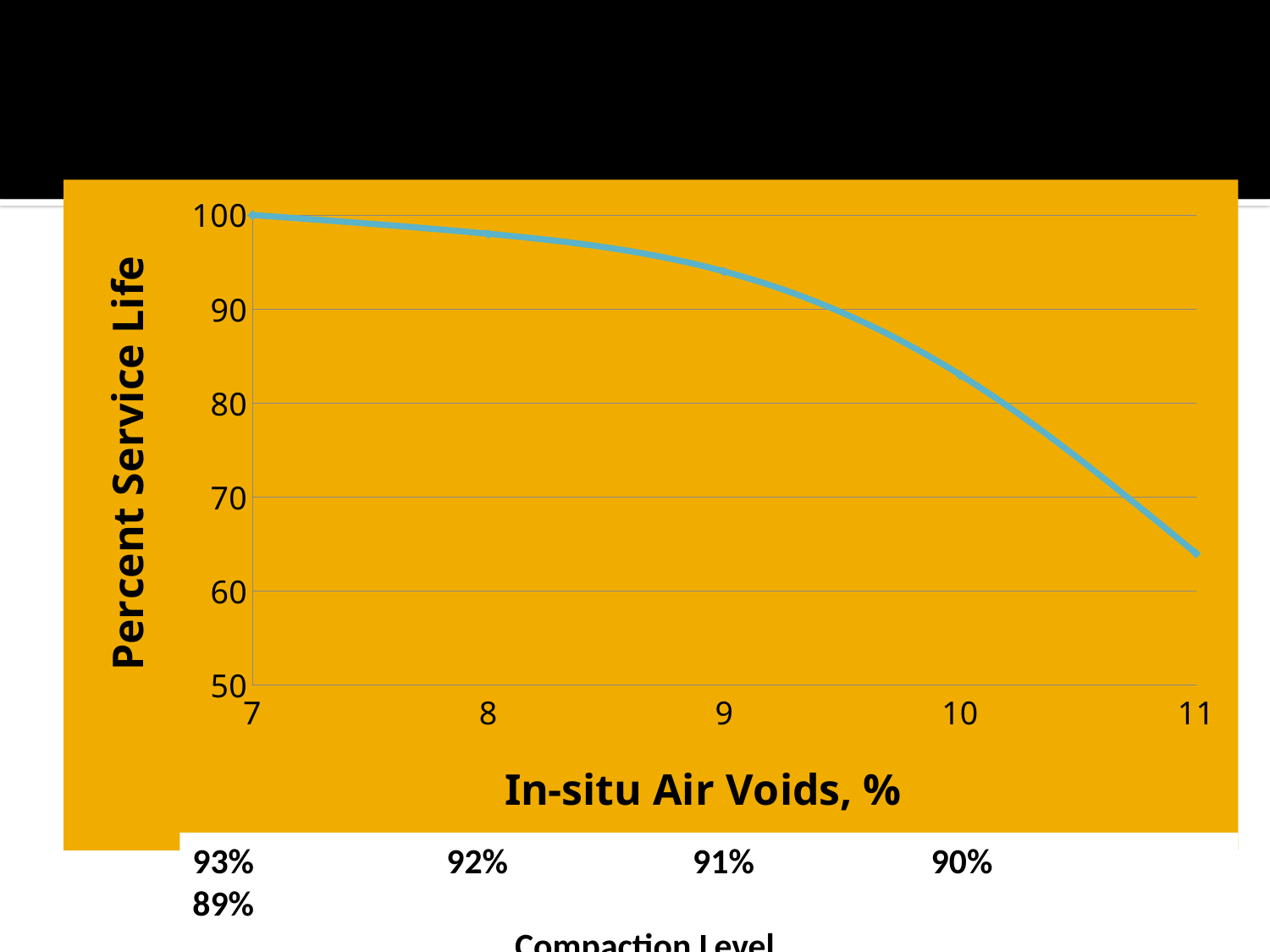
Is the Percent Service Life at 9% In-situ Air Voids greater or less than 90? greater What is the Percent Service Life at 7% In-situ Air Voids? 100 At which In-situ Air Voids value on the x axis is Percent Service Life highest? 7 Is the Percent Service Life at 11% In-situ Air Voids greater or less than 60? greater What is the label of the x axis? In-situ Air Voids, % Is the Percent Service Life at 10% In-situ Air Voids greater or less than 80? greater What kind of chart is shown on the slide? line chart What is the label of the y axis? Percent Service Life At which In-situ Air Voids value on the x axis is Percent Service Life lowest? 11 Does Percent Service Life rise or fall as In-situ Air Voids increase from 7 to 11? fall